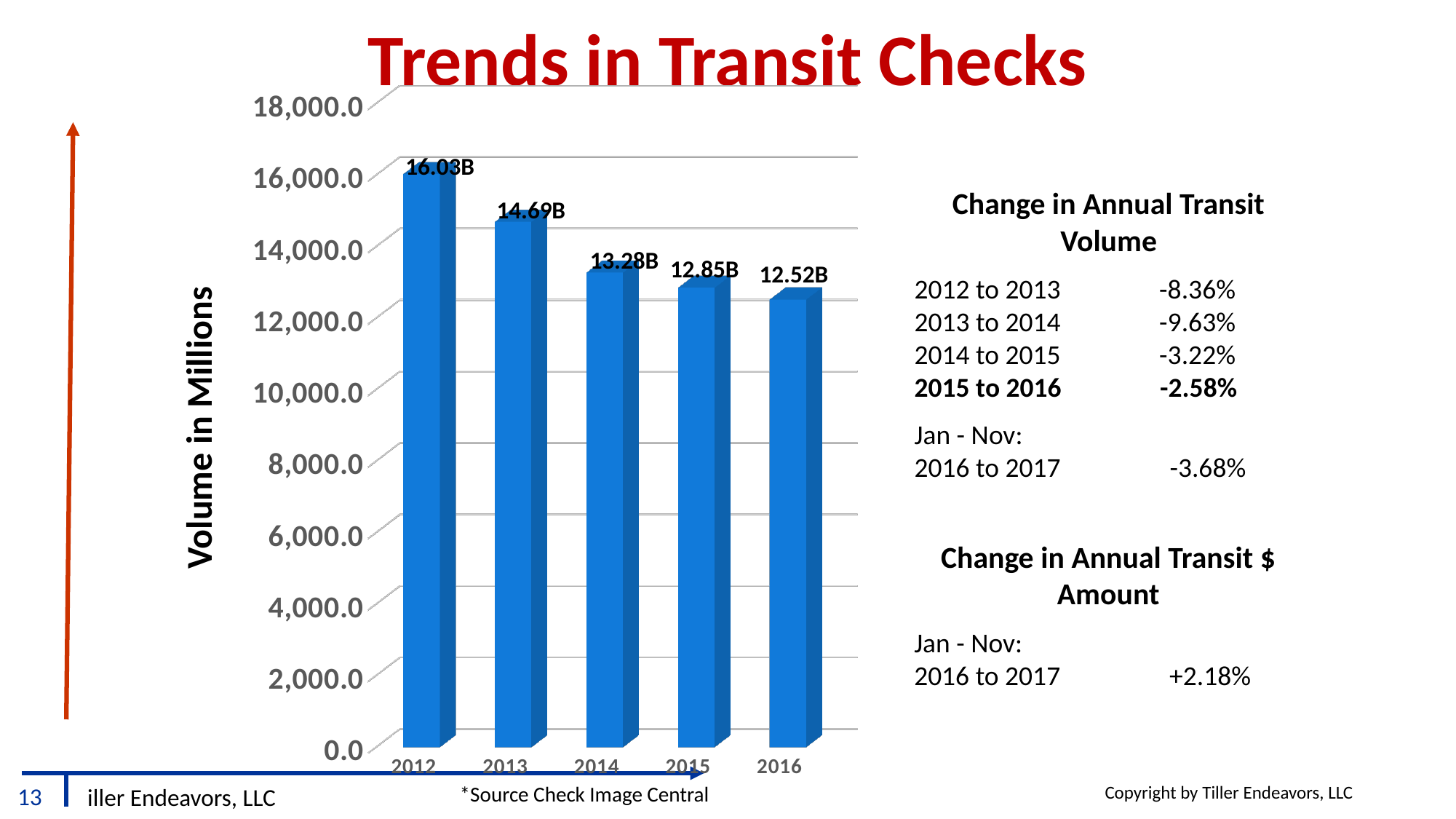
Which year has the highest transit check volume? 2012 How many years are shown on the x axis of the chart? 5 What is the transit check volume shown for 2014? 13.28B What is the difference between the 2012 and 2013 transit check volumes? 1.34B Do the transit check volumes rise or fall from 2012 to 2016? fall Is the bar for 2014 greater or less than 14,000.0 on the axis? less Which year has the lowest transit check volume? 2016 What is the transit check volume shown for 2016? 12.52B What kind of chart is used to show transit check volume? bar chart Which year has a larger transit check volume, 2013 or 2015? 2013 What is the difference between the 2015 and 2016 transit check volumes? 0.33B What is the transit check volume shown for 2012? 16.03B